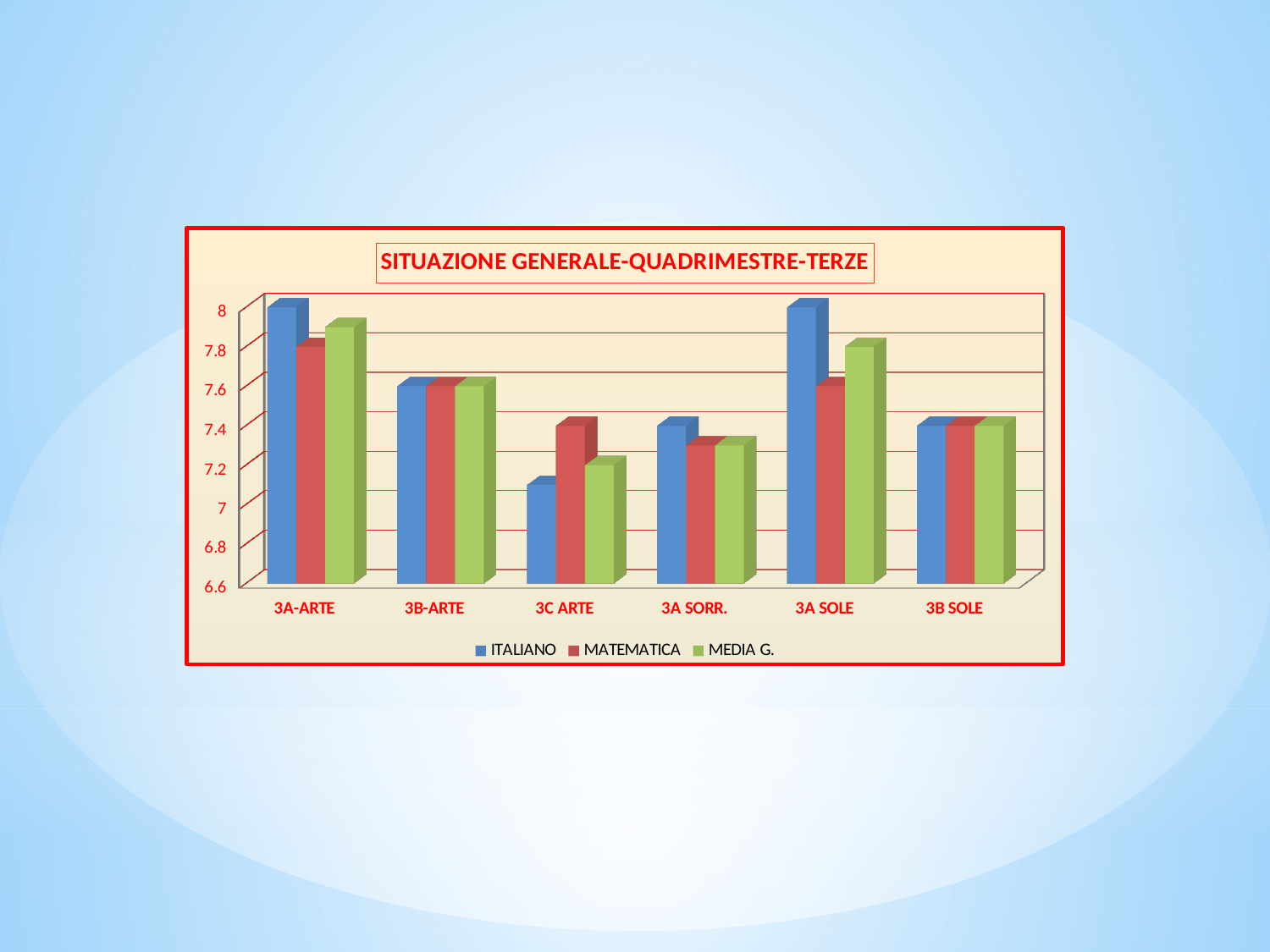
What type of chart is shown on the slide? bar chart For 3A SOLE, which is larger: the ITALIANO value or the MATEMATICA value? ITALIANO What is the ITALIANO value for 3A-ARTE? 8 How many series does the legend list? 3 Which class has the lowest ITALIANO value? 3C ARTE How many classes (categories) are shown on the x axis? 6 Which class has the highest MATEMATICA value? 3A-ARTE Is the ITALIANO value for 3C ARTE greater or less than 7.2? less Is the MEDIA G. value for 3A-ARTE greater or less than 7.8? greater What is the title of the chart? SITUAZIONE GENERALE-QUADRIMESTRE-TERZE What is the MATEMATICA value for 3B-ARTE? 7.6 What is the MEDIA G. value for 3B SOLE? 7.4